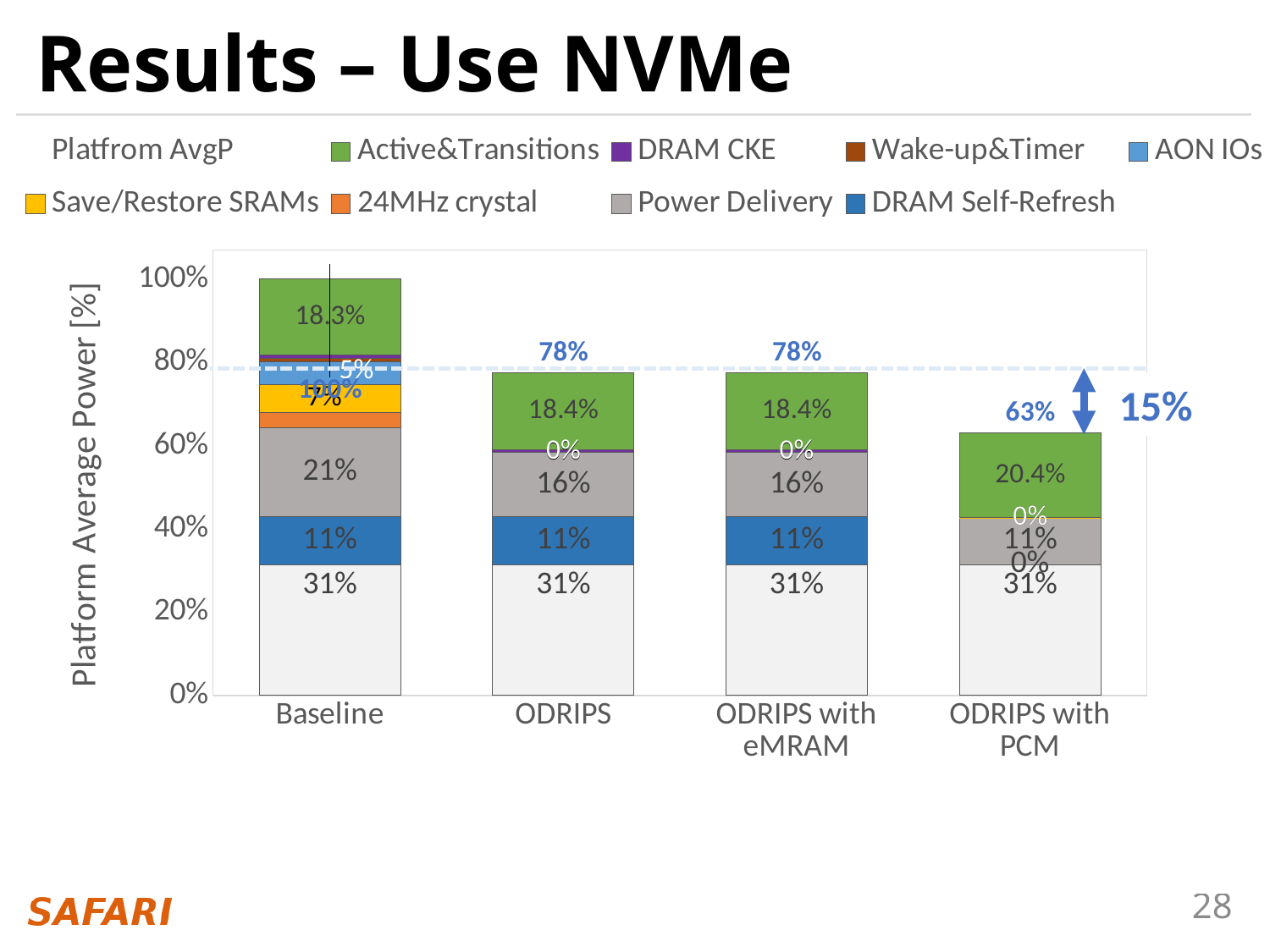
How many series does the chart's legend list? 9 What is the total platform average power labelled for ODRIPS with PCM? 63% Which is larger, the Active&Transitions value for ODRIPS with PCM or for ODRIPS? ODRIPS with PCM What is the Active&Transitions value for ODRIPS with PCM? 20.4% How many categories are shown on the x axis of the chart? 4 What is the Active&Transitions value for Baseline? 18.3% Which category has the lowest total bar? ODRIPS with PCM What is the difference between the Power Delivery value for Baseline and for ODRIPS? 5% What is the total platform average power labelled for ODRIPS with eMRAM? 78% What kind of chart is shown on the slide? Stacked bar chart What is the Power Delivery value for Baseline? 21% Which category has the highest total bar? Baseline